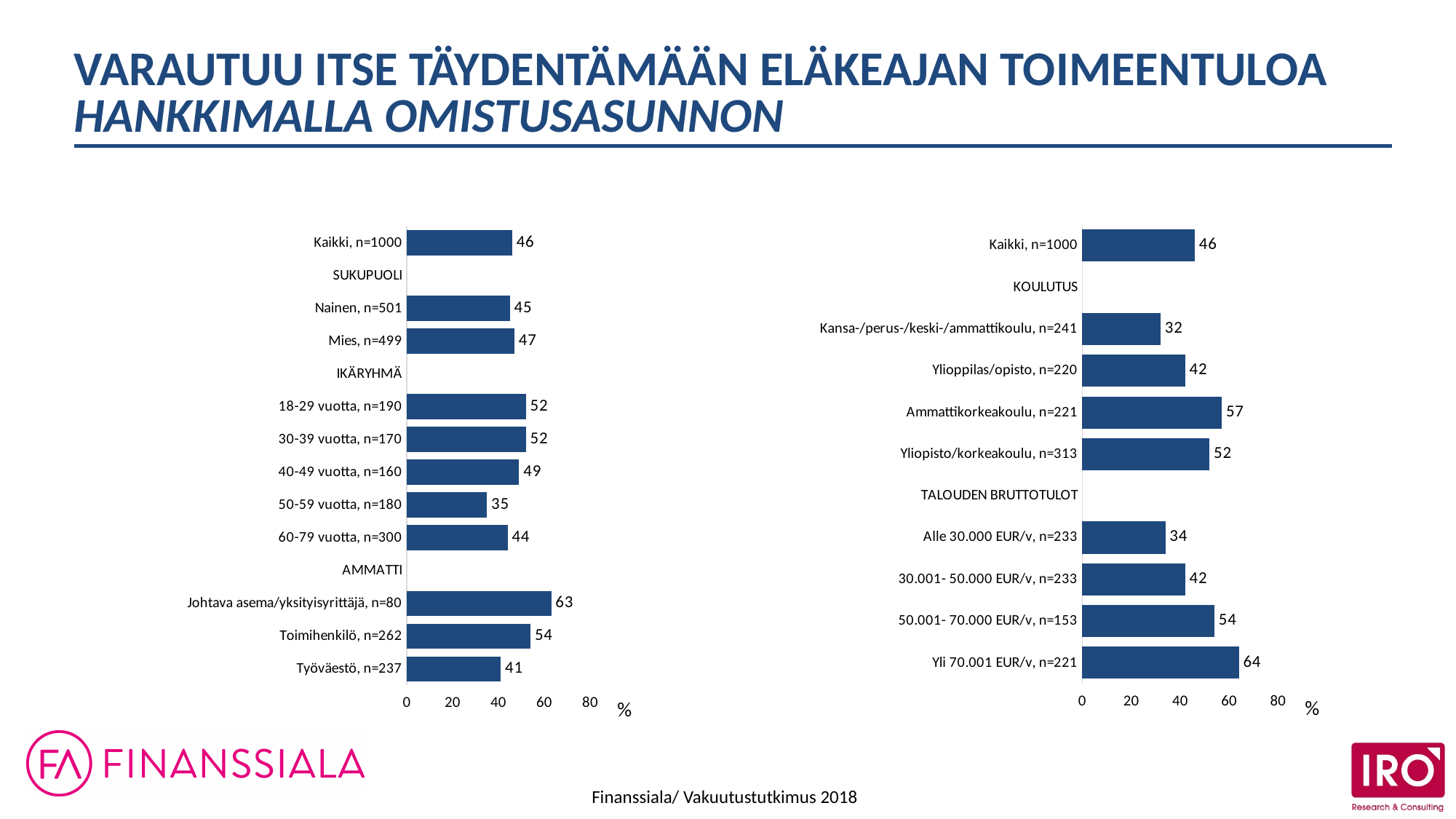
In the left chart, what is the difference between Mies, n=499 and Nainen, n=501? 2 In the left chart, which category has the lowest value? 50-59 vuotta, n=180 In the right chart, which category has the highest value? Yli 70.001 EUR/v, n=221 In the left chart, what is the value for Kaikki, n=1000? 46 In the right chart, is the value for Yliopisto/korkeakoulu, n=313 greater or less than 40? greater In the right chart, what is the difference between Yli 70.001 EUR/v, n=221 and Alle 30.000 EUR/v, n=233? 30 In the left chart, which category has the highest value? Johtava asema/yksityisyrittäjä, n=80 What kind of chart is shown on the left of the slide? Bar chart In the right chart, what is the value for Ammattikorkeakoulu, n=221? 57 In the right chart, which category has the lowest value? Kansa-/perus-/keski-/ammattikoulu, n=241 In the left chart, what is the value for 50-59 vuotta, n=180? 35 In the left chart, which is larger: Toimihenkilö, n=262 or Työväestö, n=237? Toimihenkilö, n=262